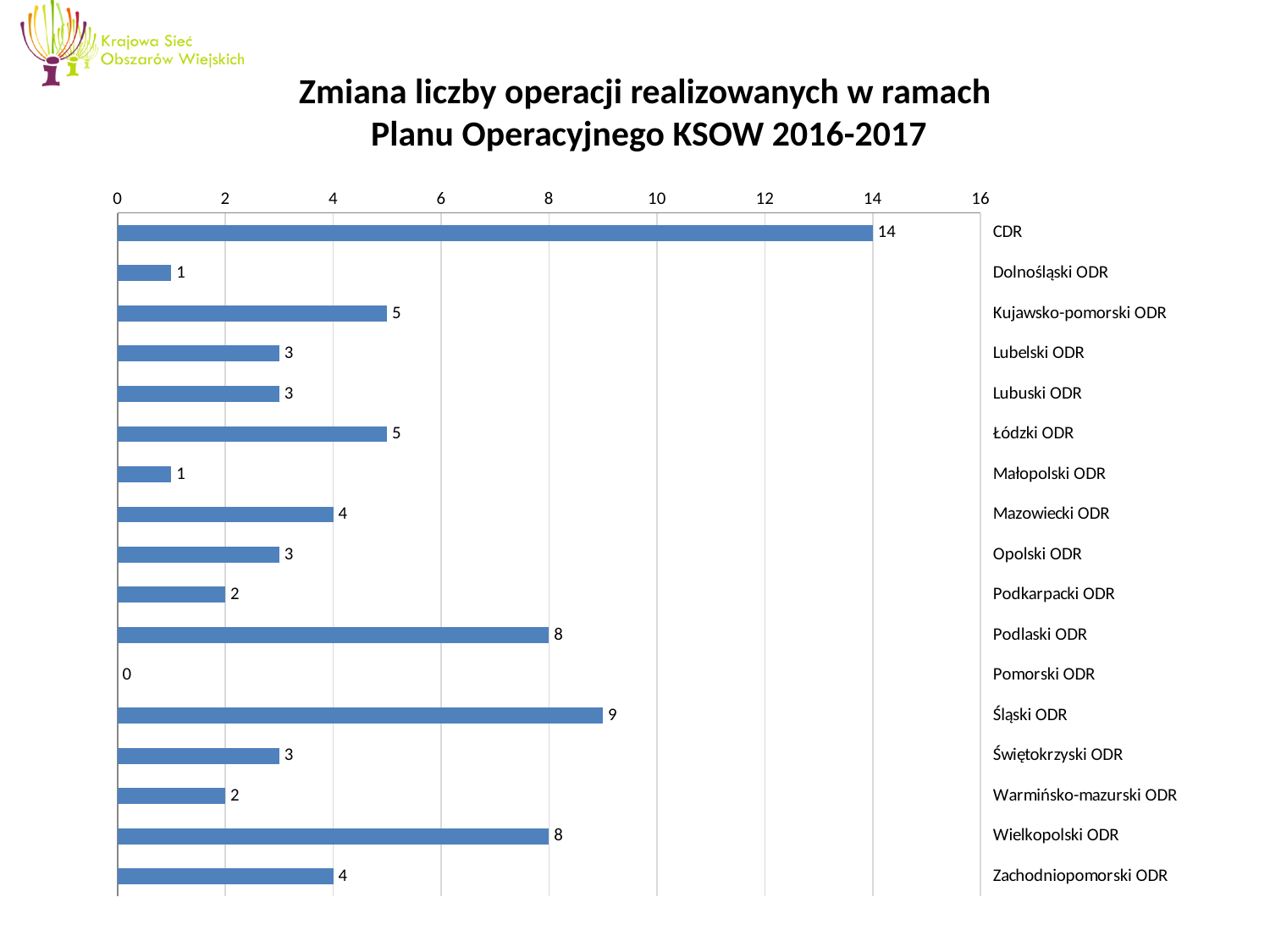
Which category has the lowest value? Pomorski ODR What is the difference between the values for Podlaski ODR and Podkarpacki ODR? 6 What is the value for Pomorski ODR? 0 What kind of chart is shown on the slide? Bar chart What is the title of the chart? Zmiana liczby operacji realizowanych w ramach Planu Operacyjnego KSOW 2016-2017 Which is larger, the value for Kujawsko-pomorski ODR or the value for Lubelski ODR? Kujawsko-pomorski ODR What is the value for CDR? 14 What is the value for Śląski ODR? 9 What is the value for Mazowiecki ODR? 4 Which category has the highest value? CDR How many categories are shown in the chart? 17 What is the difference between the values for CDR and Śląski ODR? 5